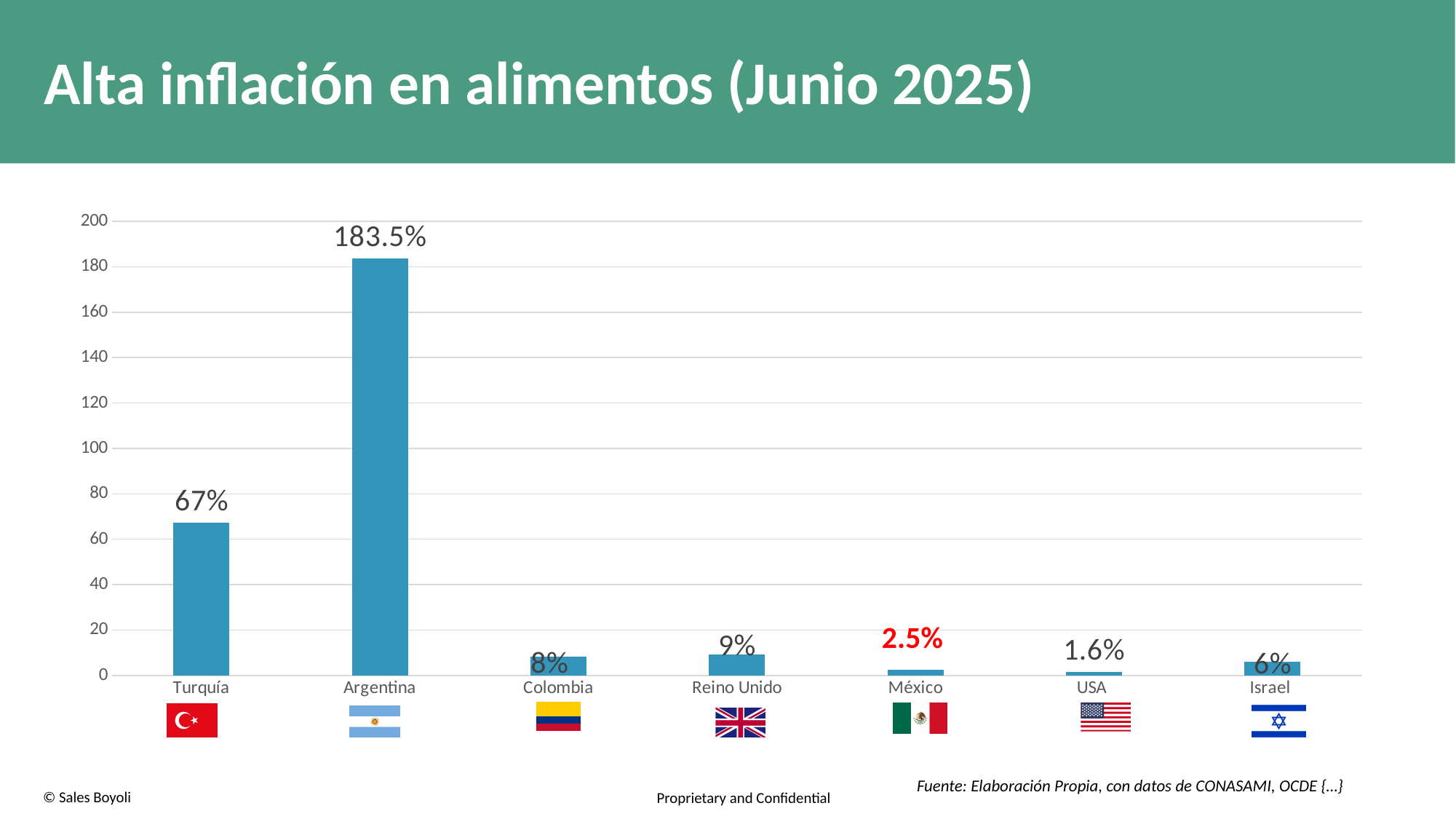
What is the value for Turquía? 67% Which is larger, the value for Israel or the value for México? Israel Which country has the highest value? Argentina What kind of chart is shown on the slide? Bar chart What is the value for México? 2.5% What is the difference between the values for Argentina and Turquía? 116.5% Which country's data label is shown in red? México What is the difference between the values for Reino Unido and Colombia? 1% Which country has the lowest value? USA What is the value for Argentina? 183.5% What is the value for USA? 1.6% How many countries are shown in the chart? 7